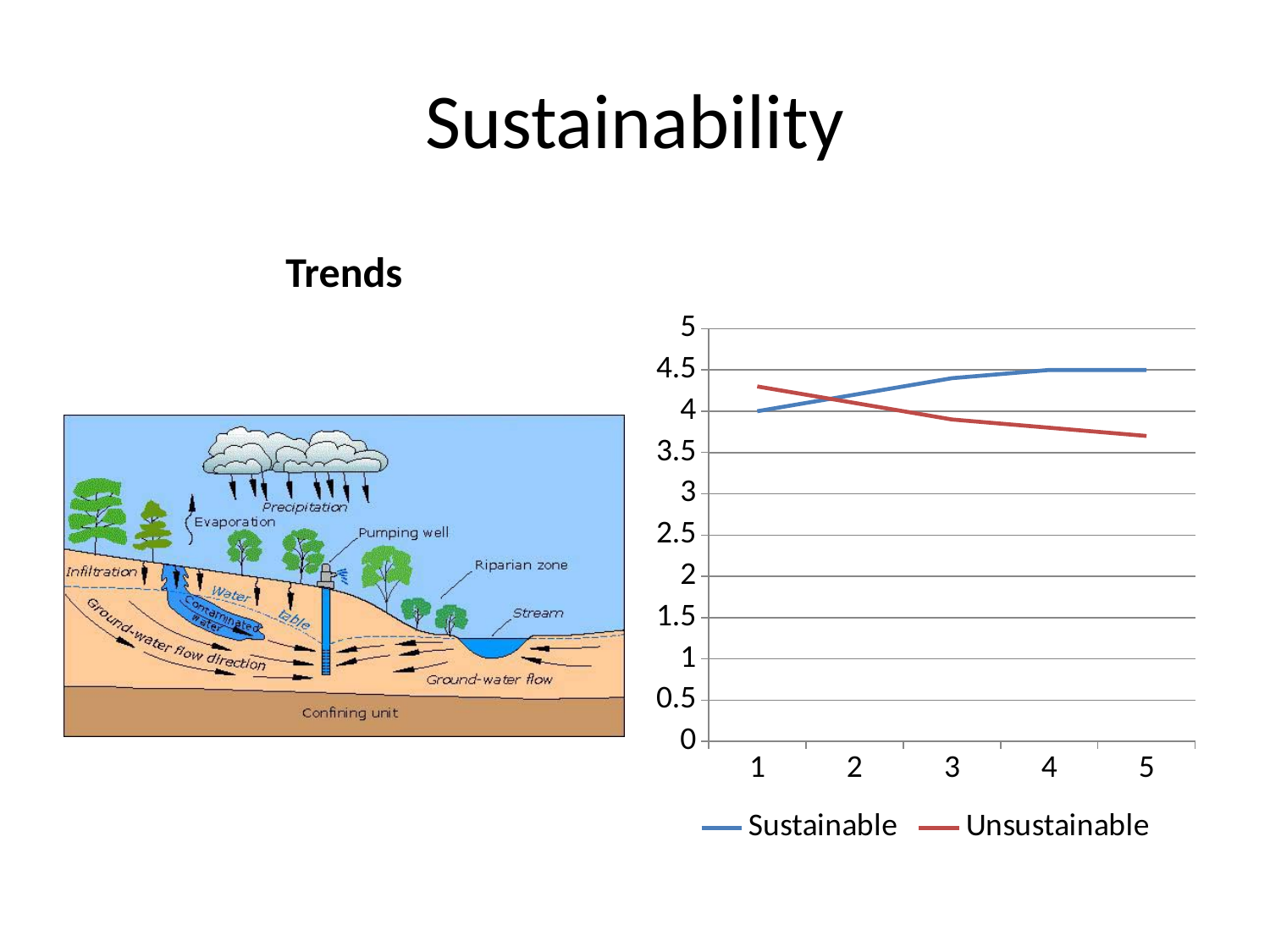
What kind of chart is shown on the slide? line chart Is the value of the Unsustainable series at x = 1 greater or less than 4? greater How many points are plotted along the x axis for each series? 5 Does the Sustainable series rise or fall from x = 1 to x = 5? rise How many series does the chart's legend list? 2 At x = 1, which series has the higher value, Sustainable or Unsustainable? Unsustainable What is the value of the Sustainable series at x = 5? 4.5 At x = 5, which series has the higher value, Sustainable or Unsustainable? Sustainable Which colour is used for the Unsustainable series in the legend? red Is the value of the Unsustainable series at x = 5 greater or less than 4? less Does the Unsustainable series rise or fall from x = 1 to x = 5? fall What is the value of the Sustainable series at x = 1? 4